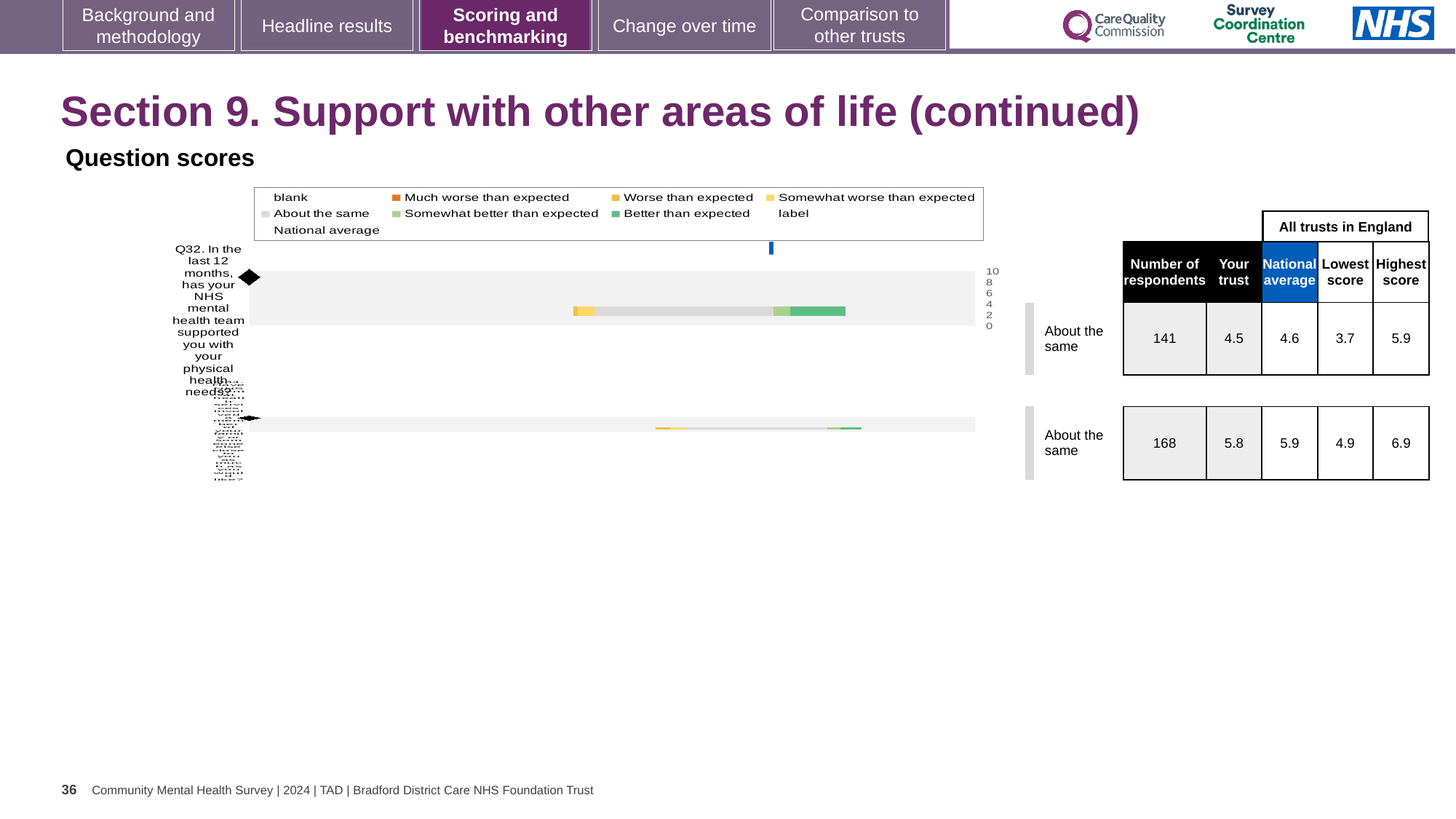
In the chart legend, what colour represents 'Better than expected'? green How is the trust's Q32 score categorised relative to expectations? About the same What is the number of respondents for Q32? 141 What is the national average score for Q32? 4.6 For Q32, what is the difference between the highest score and the lowest score among all trusts in England? 2.2 What kind of chart is shown on the slide? bar chart What is the 'Your trust' score for Q32? 4.5 In the chart legend, what colour represents 'Much worse than expected'? orange Is the 'Your trust' score for Q32 greater or less than 4? greater What is the highest score among all trusts in England for Q32? 5.9 How many questions (bars) are plotted in the chart? 2 For Q32, which is larger: the 'Your trust' score or the national average? national average